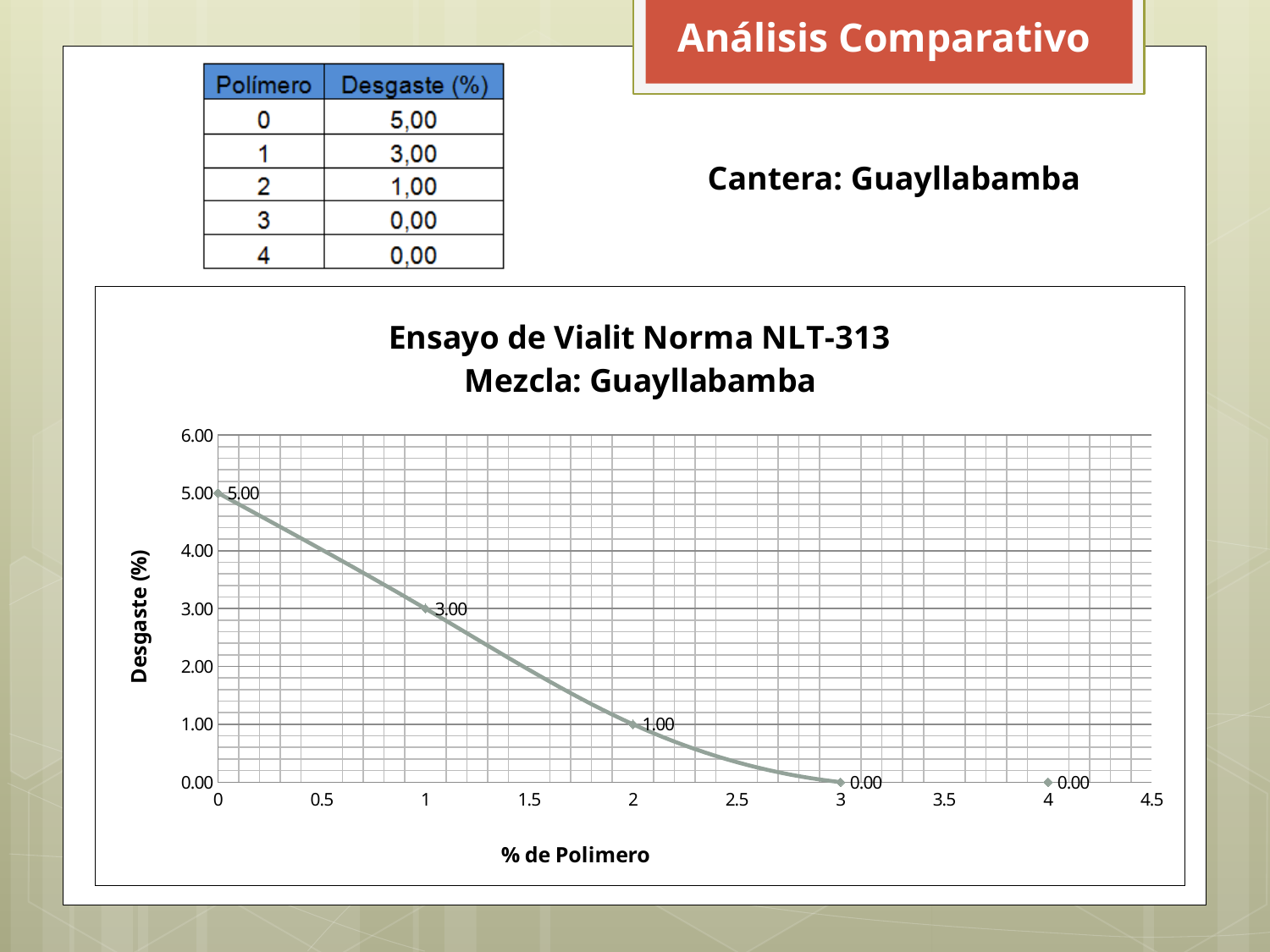
How many data points are plotted on the chart? 5 What is the Desgaste (%) value at 2 % de Polimero? 1.00 At which % de Polimero is the Desgaste (%) highest? 0 What is the Desgaste (%) value at 1 % de Polimero? 3.00 What is the Desgaste (%) value at 3 % de Polimero? 0.00 What is the title of the chart? Ensayo de Vialit Norma NLT-313 Mezcla: Guayllabamba What is the difference in Desgaste (%) between 1 and 2 % de Polimero? 2.00 Which has a larger Desgaste (%) value: 1 % de Polimero or 2 % de Polimero? 1 % de Polimero Do the Desgaste (%) values rise or fall as % de Polimero increases? Fall What kind of chart is shown on the slide? Line chart What is the Desgaste (%) value at 0 % de Polimero? 5.00 What is the difference in Desgaste (%) between 0 and 1 % de Polimero? 2.00